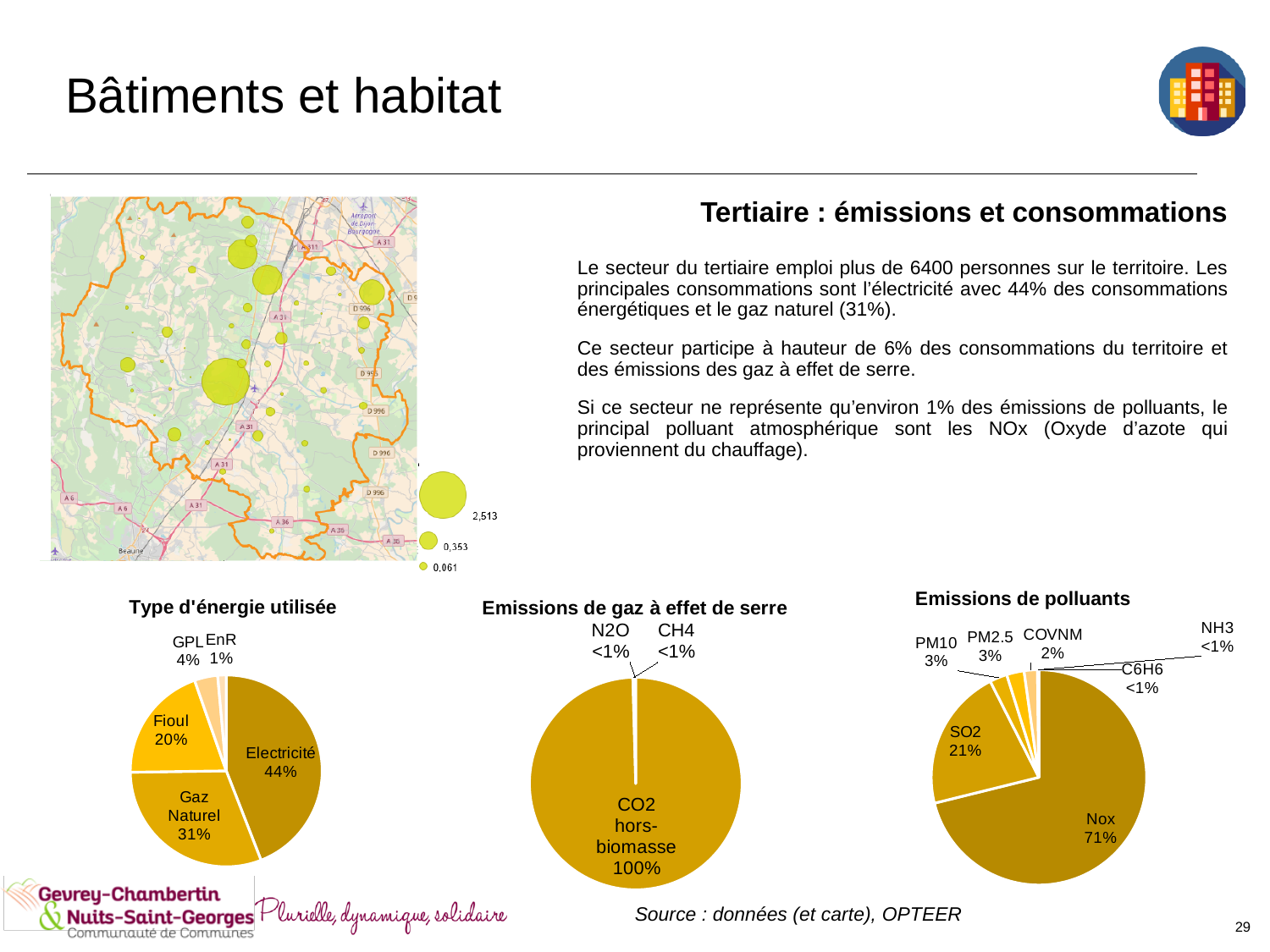
In the 'Type d'énergie utilisée' chart, what share does Electricité have? 44% In the 'Emissions de gaz à effet de serre' chart, what share is shown for CH4? <1% In the 'Type d'énergie utilisée' chart, what share does Gaz Naturel have? 31% In the 'Emissions de polluants' chart, which pollutant has the second-largest share, and what is it? SO2, 21% In the 'Emissions de polluants' chart, which is larger, the share of SO2 or the share of PM10? SO2 In the 'Emissions de gaz à effet de serre' chart, what share does CO2 hors-biomasse have? 100% In the 'Type d'énergie utilisée' chart, how many energy types are shown? 5 In the 'Type d'énergie utilisée' chart, which energy type has the smallest share? EnR In the 'Emissions de polluants' chart, what share does Nox have? 71% In the 'Type d'énergie utilisée' chart, what is the difference between the shares of Electricité and Fioul? 24% In the 'Type d'énergie utilisée' chart, which energy type has the largest share? Electricité What type of chart is used for 'Emissions de polluants'? Pie chart